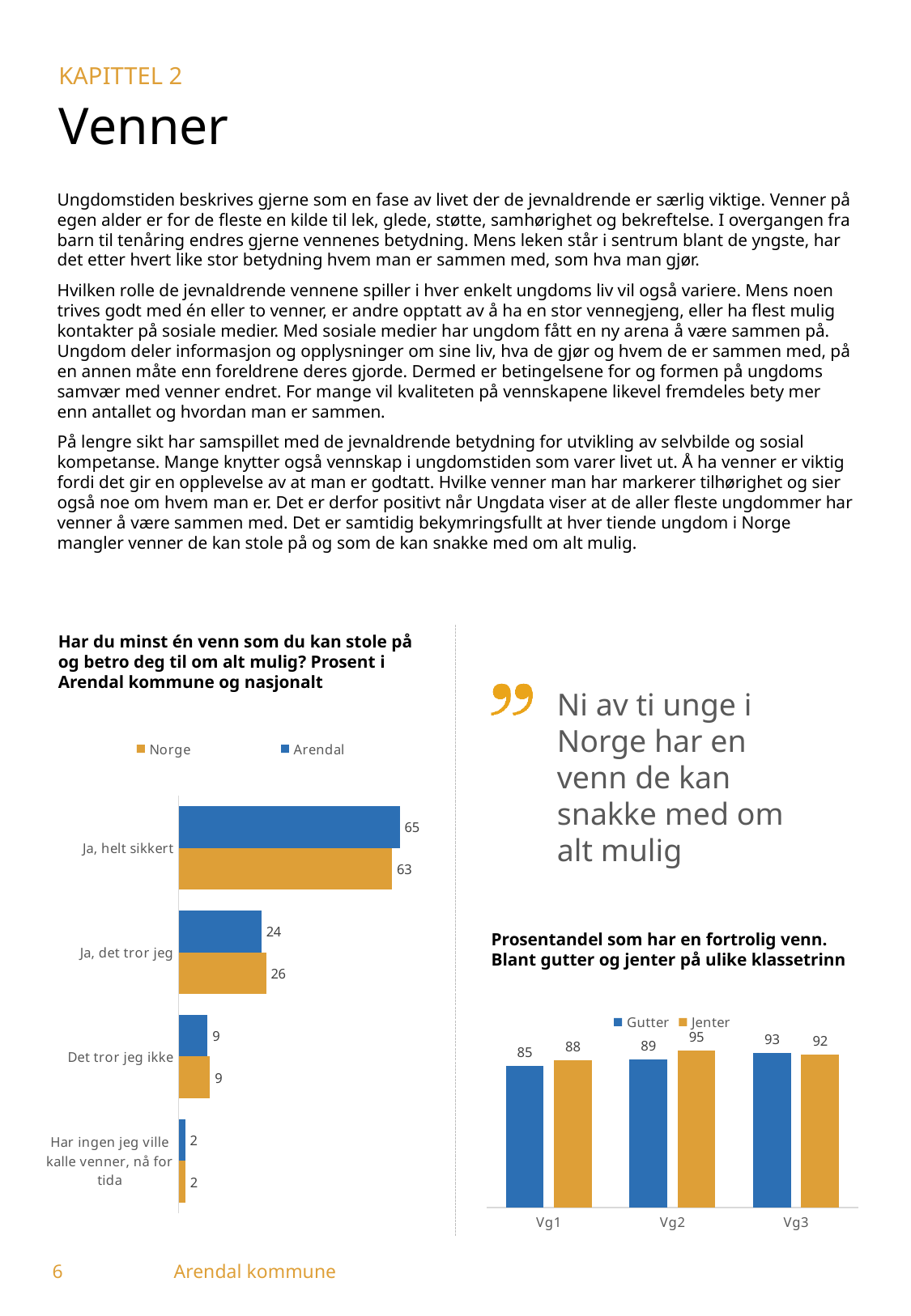
In the right chart (Prosentandel som har en fortrolig venn), what is the difference between Jenter and Gutter at Vg2? 6 What kind of chart is the left chart (Har du minst én venn som du kan stole på...)? Bar chart In the left chart (Har du minst én venn som du kan stole på...), which category has the lowest values? Har ingen jeg ville kalle venner, nå for tida In the left chart (Har du minst én venn som du kan stole på...), how many series does the legend list? 2 In the left chart (Har du minst én venn som du kan stole på...), what is the value for Arendal for 'Ja, helt sikkert'? 65 In the left chart (Har du minst én venn som du kan stole på...), what is the value for Norge for 'Ja, det tror jeg'? 26 In the left chart (Har du minst én venn som du kan stole på...), how many categories are shown? 4 In the left chart (Har du minst én venn som du kan stole på...), what is the difference between the Arendal and Norge values for 'Ja, helt sikkert'? 2 In the right chart (Prosentandel som har en fortrolig venn), what is the value for Jenter at Vg2? 95 In the right chart (Prosentandel som har en fortrolig venn), do the Gutter values rise or fall from Vg1 to Vg3? Rise In the right chart (Prosentandel som har en fortrolig venn), which is larger at Vg1: Gutter or Jenter? Jenter In the right chart (Prosentandel som har en fortrolig venn), what is the value for Gutter at Vg3? 93